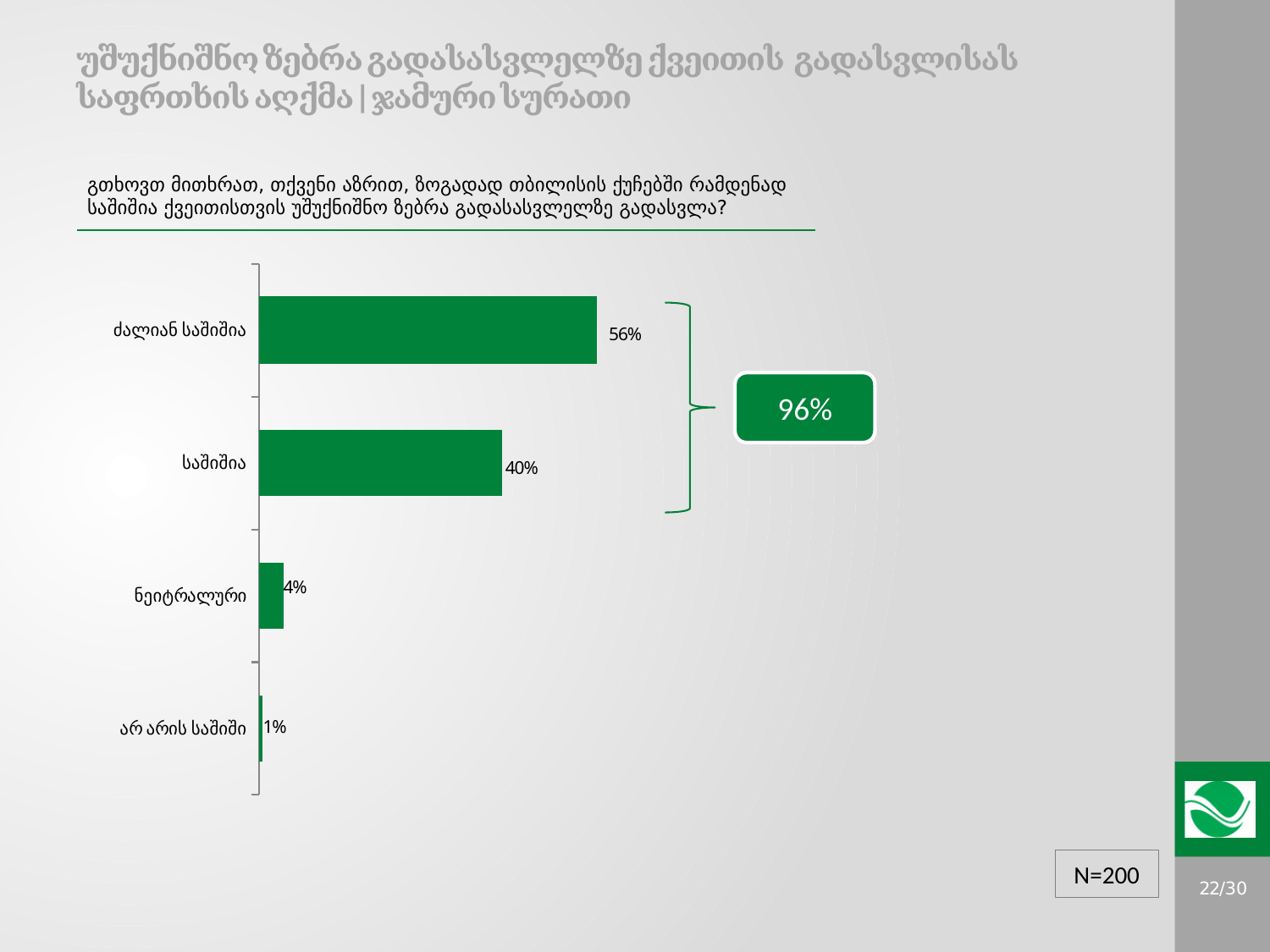
What is the difference between the values for ძალიან საშიშია and საშიშია? 16% What kind of chart is shown on the slide? bar chart Which category has the highest value? ძალიან საშიშია What is the value for ძალიან საშიშია? 56% What combined percentage is shown in the green box next to the bracket grouping the top two bars? 96% What sample size (N) is shown on the slide? N=200 Which category has the lowest value? არ არის საშიში How many categories are shown in the chart? 4 What is the value for არ არის საშიში? 1% What is the value for საშიშია? 40% What is the value for ნეიტრალური? 4% Which is larger, the value for საშიშია or the value for ნეიტრალური? საშიშია